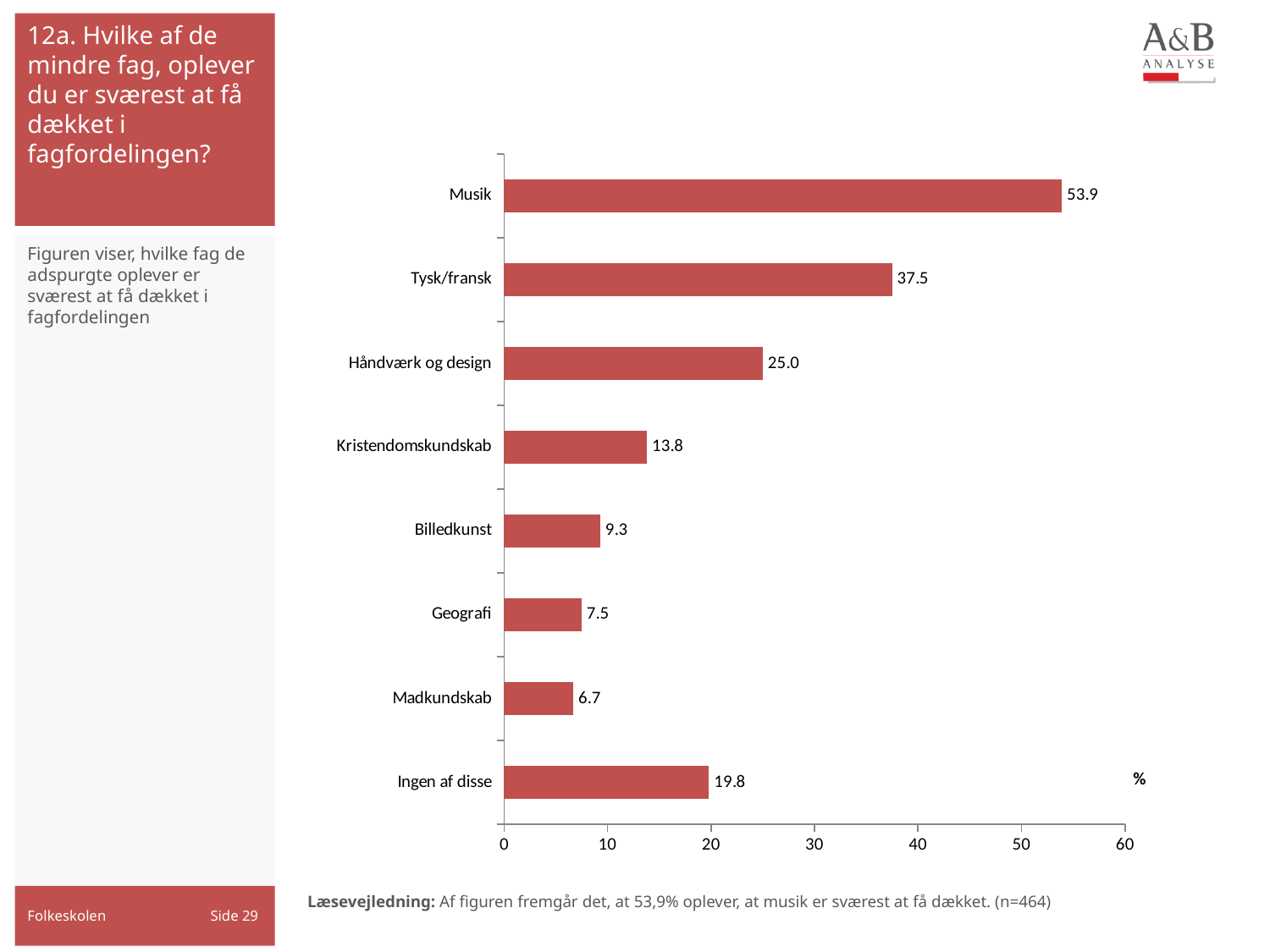
Which category has the highest value? Musik Is the value for Håndværk og design greater or less than 20? greater What is the value for Musik? 53.9 What colour are the bars in the chart? red Which category has the lowest value? Madkundskab How many categories are shown in the chart? 8 What is the value for Ingen af disse? 19.8 Which is larger, the value for Billedkunst or the value for Geografi? Billedkunst What is the maximum value shown on the horizontal axis? 60 What is the value for Kristendomskundskab? 13.8 What is the difference between the values for Musik and Tysk/fransk? 16.4 What kind of chart is shown on the slide? bar chart